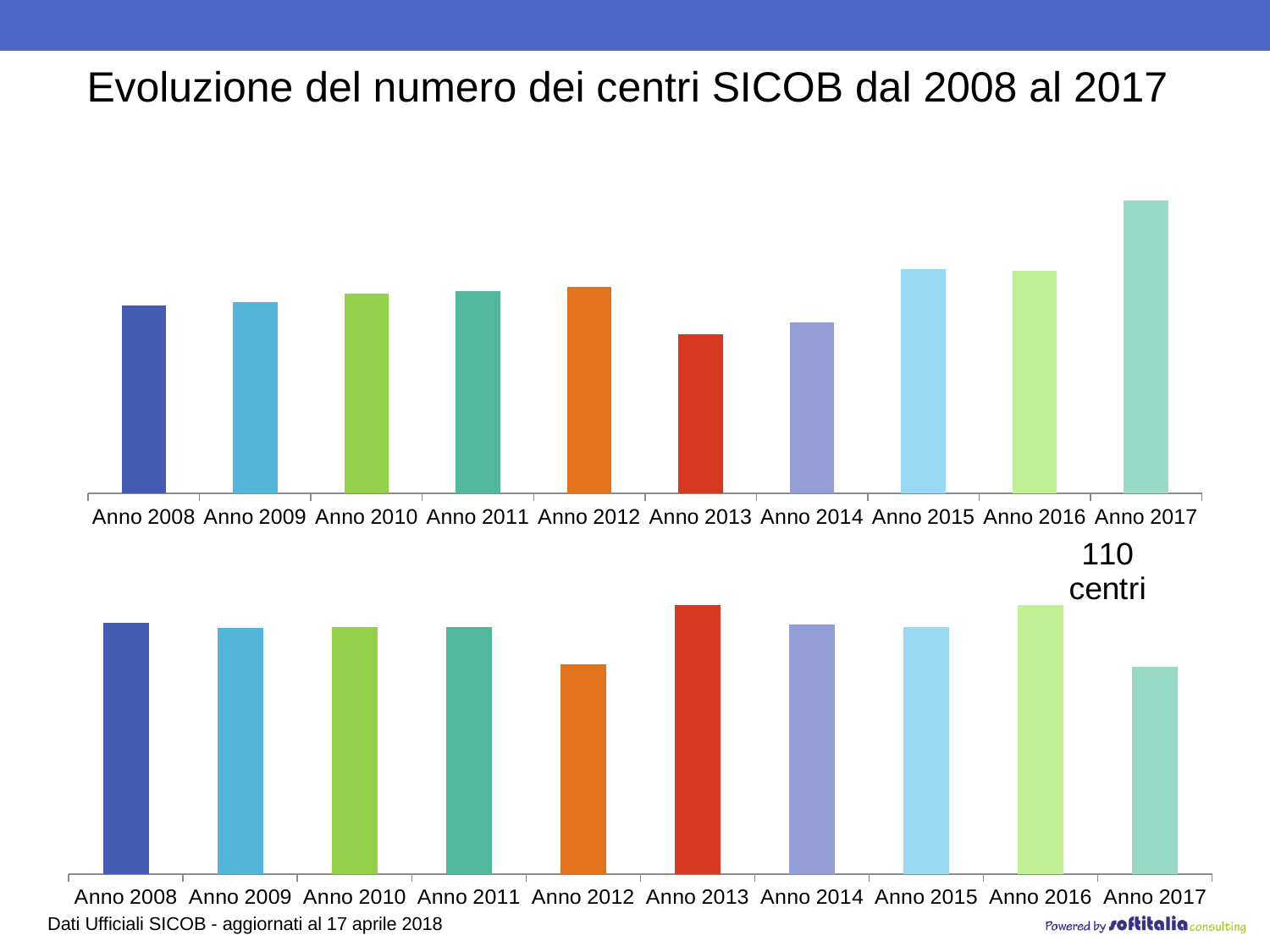
In the bottom chart, what annotation is written above the bar for Anno 2016? 110 centri In the bottom chart, which is larger, the value for Anno 2016 or the value for Anno 2017? Anno 2016 In the top chart, which is larger, the value for Anno 2014 or the value for Anno 2013? Anno 2014 In the top chart, which is larger, the value for Anno 2017 or the value for Anno 2008? Anno 2017 In the top chart, does the value for Anno 2017 rise or fall compared with Anno 2016? rise In the top chart, what kind of chart is shown? bar chart In the top chart, which year has the lowest bar? Anno 2013 What is the title of the slide containing the two charts? Evoluzione del numero dei centri SICOB dal 2008 al 2017 In the top chart, which year has the highest bar? Anno 2017 In the top chart, how many categories (years) are plotted? 10 In the bottom chart, how many categories (years) are plotted? 10